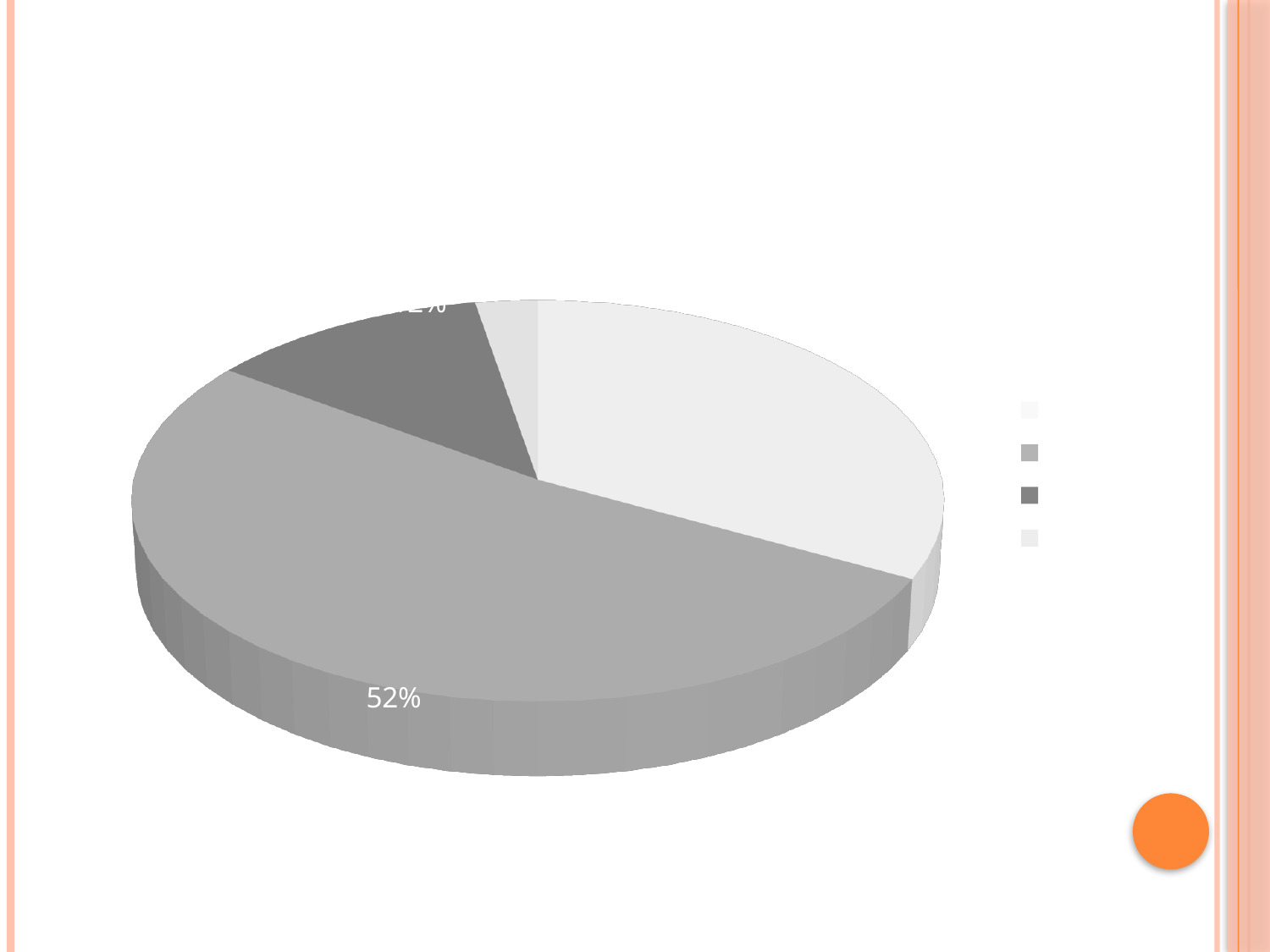
What percentage is printed on the largest slice of the pie chart? 52% How many entries does the legend of the pie chart list? 4 Which slice of the pie chart is the largest: the medium grey slice, the dark grey slice, or the very light slice? the medium grey slice How many slices does the pie chart have? 4 Which slice of the pie chart is larger: the very light slice on the right or the dark grey slice? the very light slice on the right Which slice of the pie chart is the smallest: the medium grey slice, the dark grey slice, or the small pale slice at the top? the small pale slice at the top What kind of chart is shown on the slide? pie chart Does the pie chart have a title? No